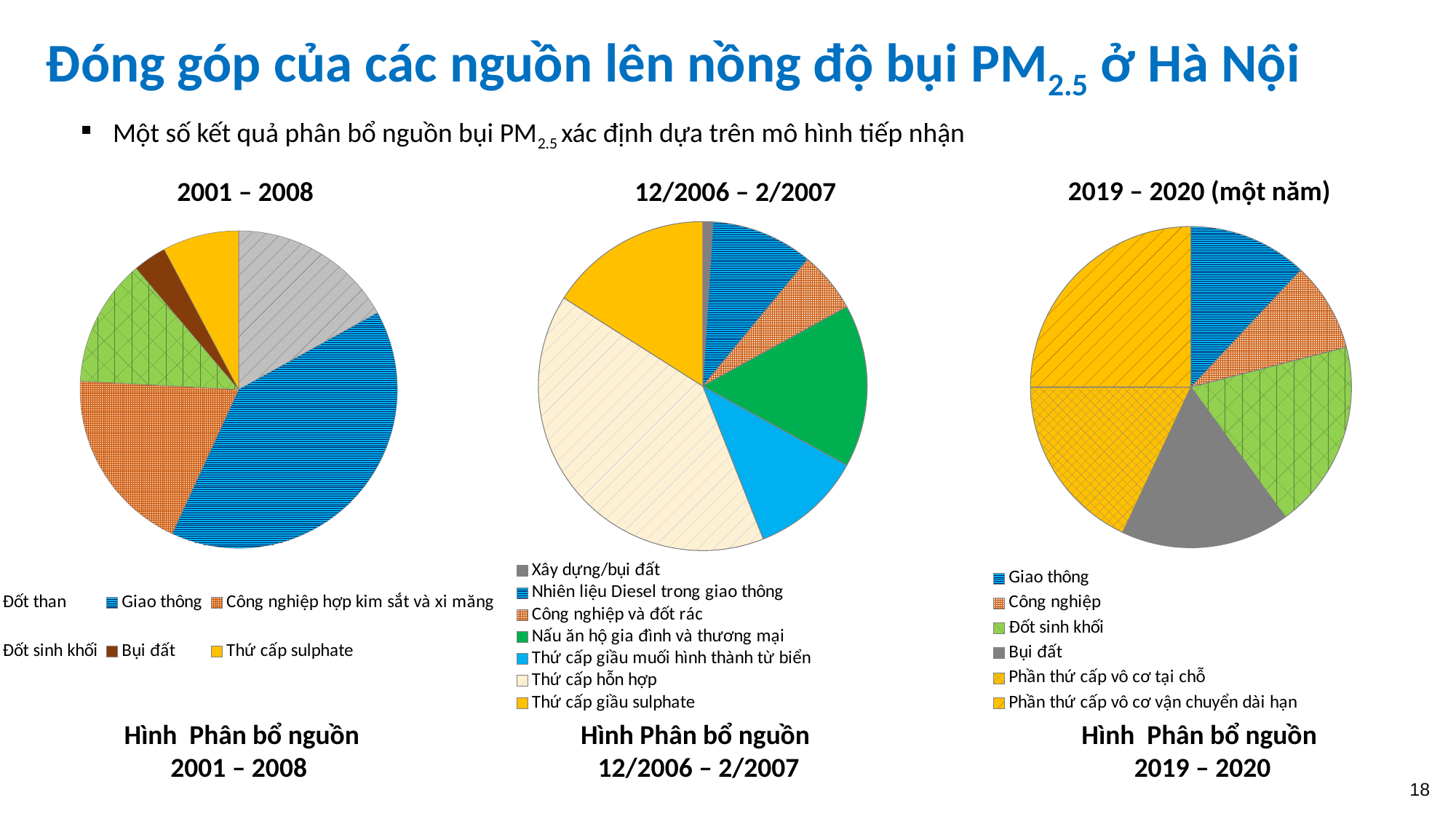
In the 12/2006 – 2/2007 pie chart, how many source categories does the legend list? 7 In the 12/2006 – 2/2007 pie chart, which slice is larger: Nấu ăn hộ gia đình và thương mại or Công nghiệp và đốt rác? Nấu ăn hộ gia đình và thương mại In the 2001 – 2008 pie chart, which source has the largest slice? Giao thông In the 2019 – 2020 (một năm) pie chart, which source has the smallest slice? Công nghiệp In the 2001 – 2008 pie chart, how many source categories does the legend list? 6 What kind of chart is used for the 2001 – 2008 source apportionment? Pie chart In the 12/2006 – 2/2007 pie chart, which source has the largest slice? Thứ cấp hỗn hợp How many pie charts are shown on the slide? 3 In the 2001 – 2008 pie chart, which slice is larger: Giao thông or Đốt than? Giao thông In the 2019 – 2020 (một năm) pie chart, how many source categories does the legend list? 6 In the 2001 – 2008 pie chart, which source has the smallest slice? Bụi đất In the 12/2006 – 2/2007 pie chart, which source has the smallest slice? Xây dựng/bụi đất